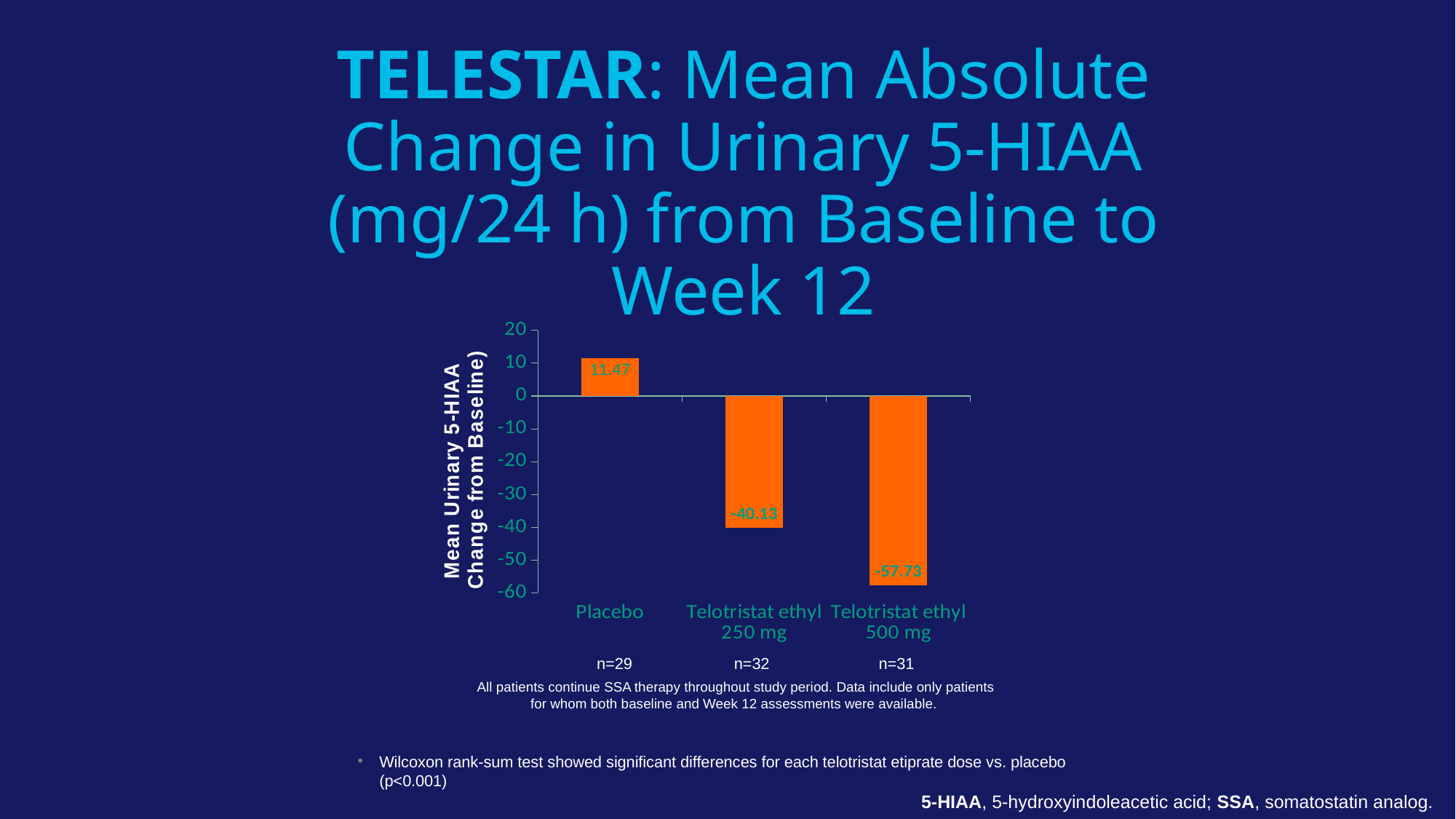
What is the mean change in urinary 5-HIAA for Telotristat ethyl 500 mg? -57.73 Which group has the lowest mean change in urinary 5-HIAA? Telotristat ethyl 500 mg Which group has the highest mean change in urinary 5-HIAA? Placebo What is the mean change in urinary 5-HIAA for Telotristat ethyl 250 mg? -40.13 What kind of chart is shown on the slide? Bar chart How many groups are shown on the x axis? 3 Is the value for Telotristat ethyl 500 mg greater or less than -50? less What is the difference between the values for Placebo and Telotristat ethyl 250 mg? 51.60 Which is larger, the value for Placebo or the value for Telotristat ethyl 500 mg? Placebo What is the mean change in urinary 5-HIAA for Placebo? 11.47 What is the label of the y axis? Mean Urinary 5-HIAA Change from Baseline What is the difference between the values for Telotristat ethyl 250 mg and Telotristat ethyl 500 mg? 17.60